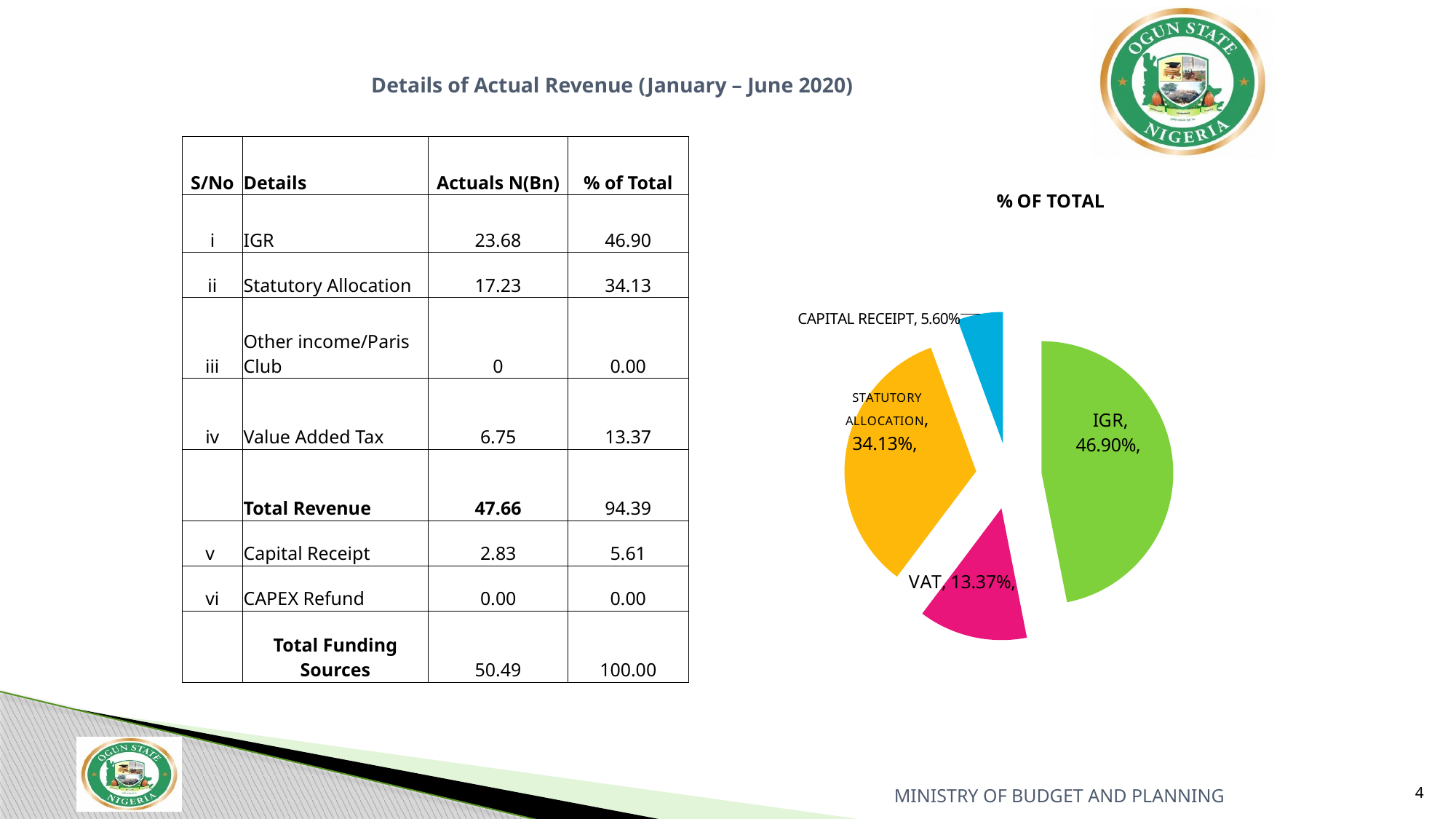
In the pie chart, what percentage is shown for VAT? 13.37% How many slices does the pie chart have? 4 Which slice of the pie chart is the smallest? CAPITAL RECEIPT What is the title of the pie chart? % OF TOTAL In the pie chart, what is the difference in percentage points between IGR and STATUTORY ALLOCATION? 12.77 In the pie chart, which is larger: VAT or CAPITAL RECEIPT? VAT In the pie chart, what percentage is shown for STATUTORY ALLOCATION? 34.13% What kind of chart is shown on the slide? Pie chart In the pie chart, what percentage is shown for CAPITAL RECEIPT? 5.60% Which slice of the pie chart is the largest? IGR What colour is the IGR slice in the pie chart? Green In the pie chart, what percentage is shown for IGR? 46.90%